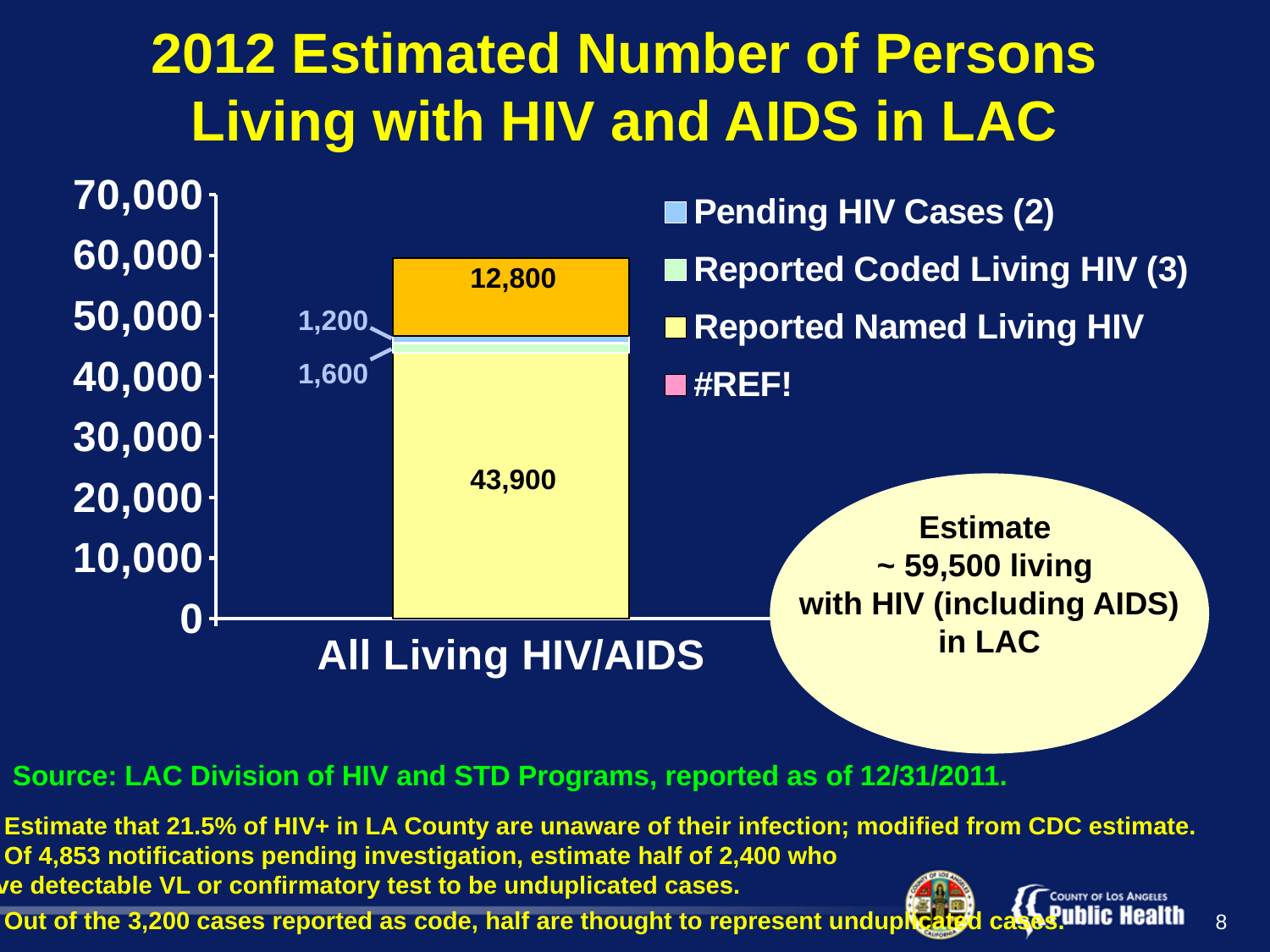
Which labelled segment of the stacked bar has the smallest value? Pending HIV Cases (2) How many categories are plotted on the x axis of the chart? 1 What is the value of the Pending HIV Cases (2) segment of the bar? 1,200 Which labelled segment of the stacked bar has the largest value? Reported Named Living HIV How many series does the chart legend list? 4 What is the category label shown on the x axis of the chart? All Living HIV/AIDS What is the total of all segments in the All Living HIV/AIDS stacked bar? 59,500 What is the difference between the 12,800 segment and the 1,600 segment? 11,200 What is the value of the Reported Named Living HIV segment of the bar? 43,900 Is the total height of the All Living HIV/AIDS bar greater or less than 50,000? greater What kind of chart is shown on the slide? bar chart What is the value of the Reported Coded Living HIV (3) segment of the bar? 1,600